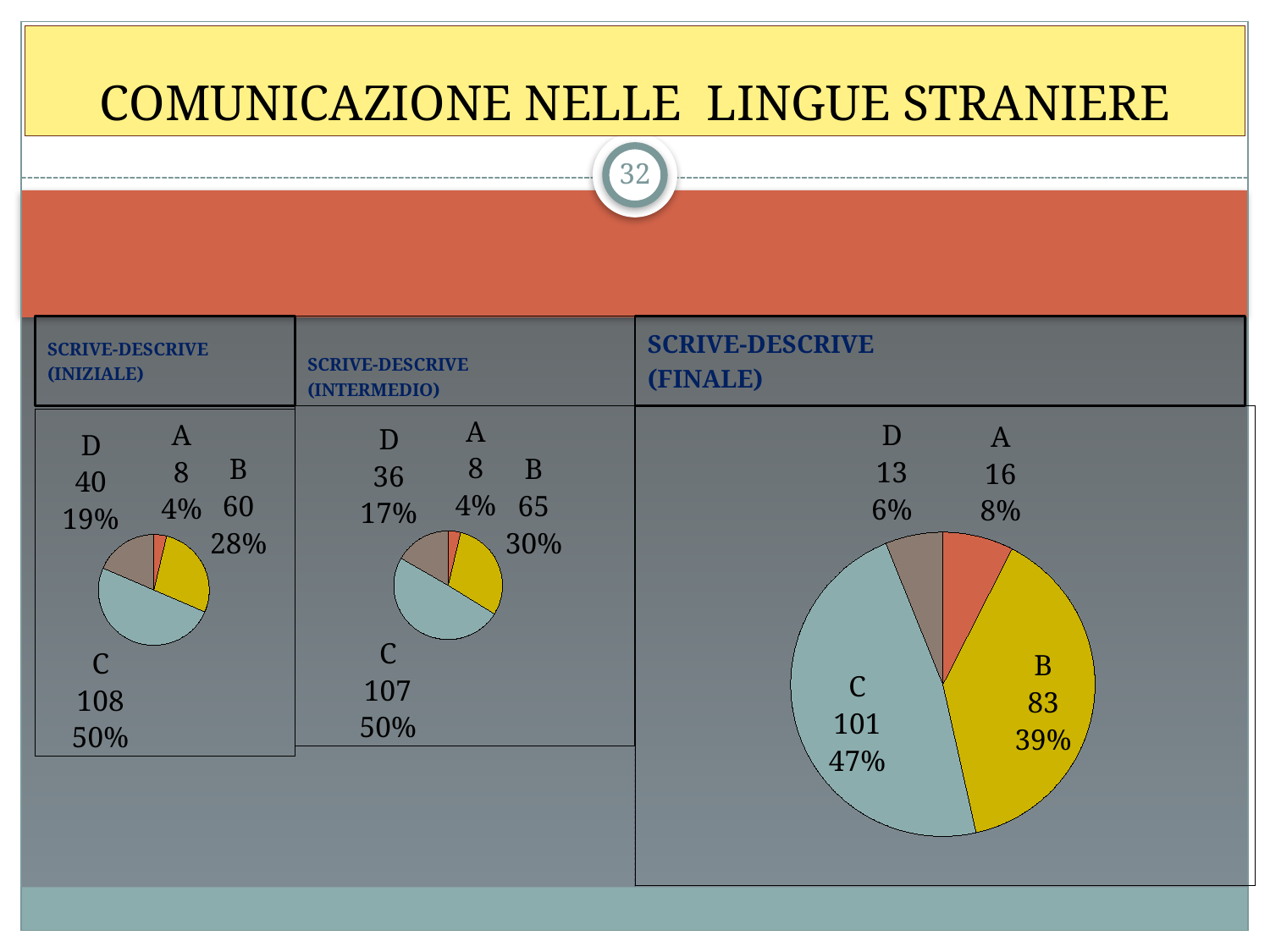
What kind of chart is the SCRIVE-DESCRIVE (INTERMEDIO) chart? Pie chart How many charts are shown on the slide? 3 In the SCRIVE-DESCRIVE (INIZIALE) chart, which is larger, the value for D or the value for B? B How many categories does the SCRIVE-DESCRIVE (FINALE) chart show? 4 In the SCRIVE-DESCRIVE (FINALE) chart, what is the difference between the values for C and B? 18 In the SCRIVE-DESCRIVE (FINALE) chart, which category has the largest value? C In the SCRIVE-DESCRIVE (INIZIALE) chart, what is the value for category C? 108 In the SCRIVE-DESCRIVE (INIZIALE) chart, what percentage share does category B have? 28% In the SCRIVE-DESCRIVE (INTERMEDIO) chart, what is the value for category D? 36 In the SCRIVE-DESCRIVE (INTERMEDIO) chart, which category has the smallest value? A In the SCRIVE-DESCRIVE (FINALE) chart, what is the value for category B? 83 In the SCRIVE-DESCRIVE (FINALE) chart, what percentage share does category C have? 47%